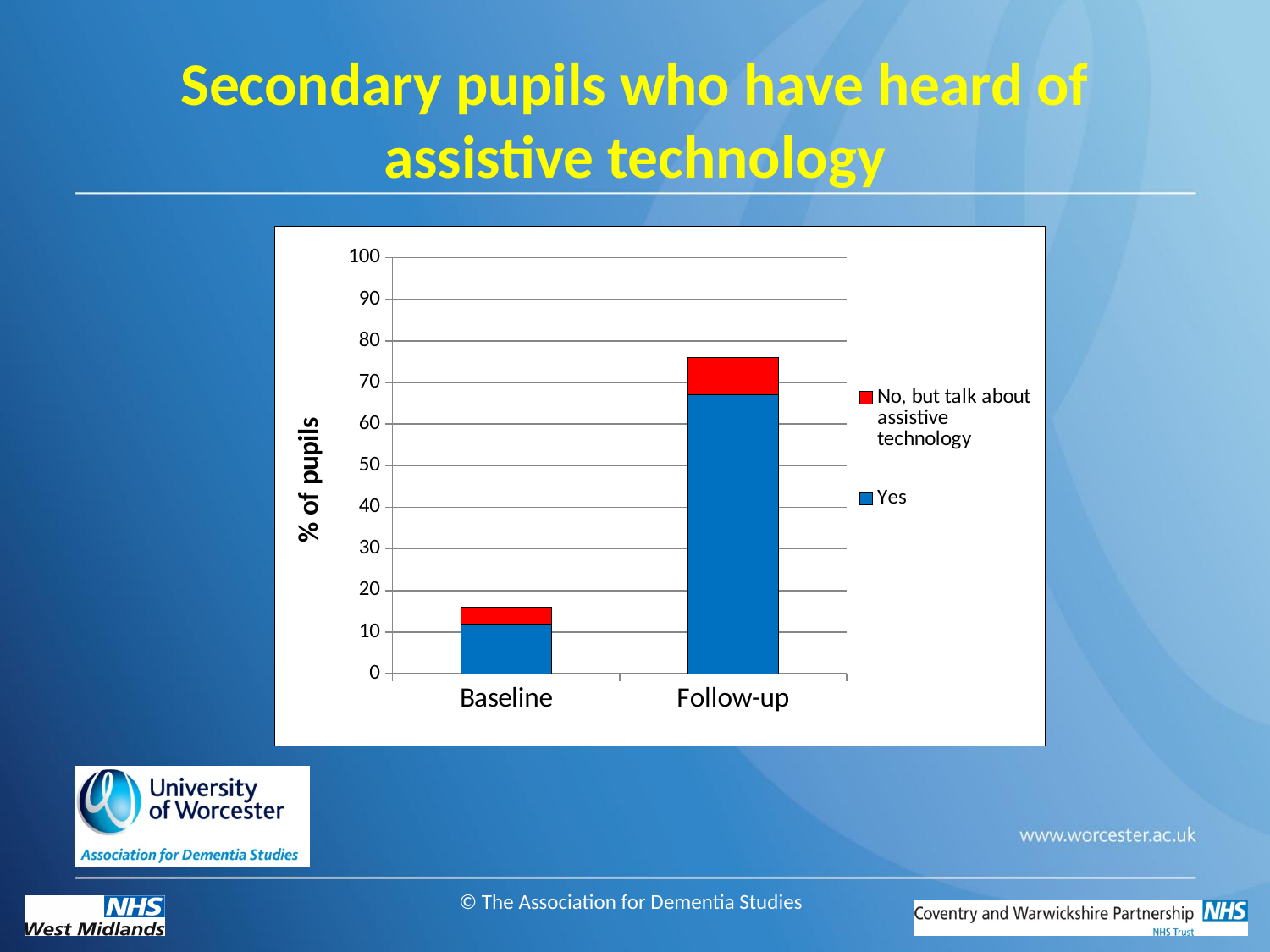
What kind of chart is shown on the slide? stacked bar chart Which category has the lowest total bar height? Baseline Is the 'Yes' value for Follow-up greater or less than 60? greater How many series does the chart's legend list? 2 Is the total bar height for Follow-up greater or less than 80? less Which colour represents the 'Yes' series in the chart? blue Which category has the taller stacked bar, Baseline or Follow-up? Follow-up What is the label on the vertical axis of the chart? % of pupils Is the total bar height for Follow-up greater or less than 70? greater Do the bar heights rise or fall from Baseline to Follow-up? rise How many categories are shown on the x axis of the chart? 2